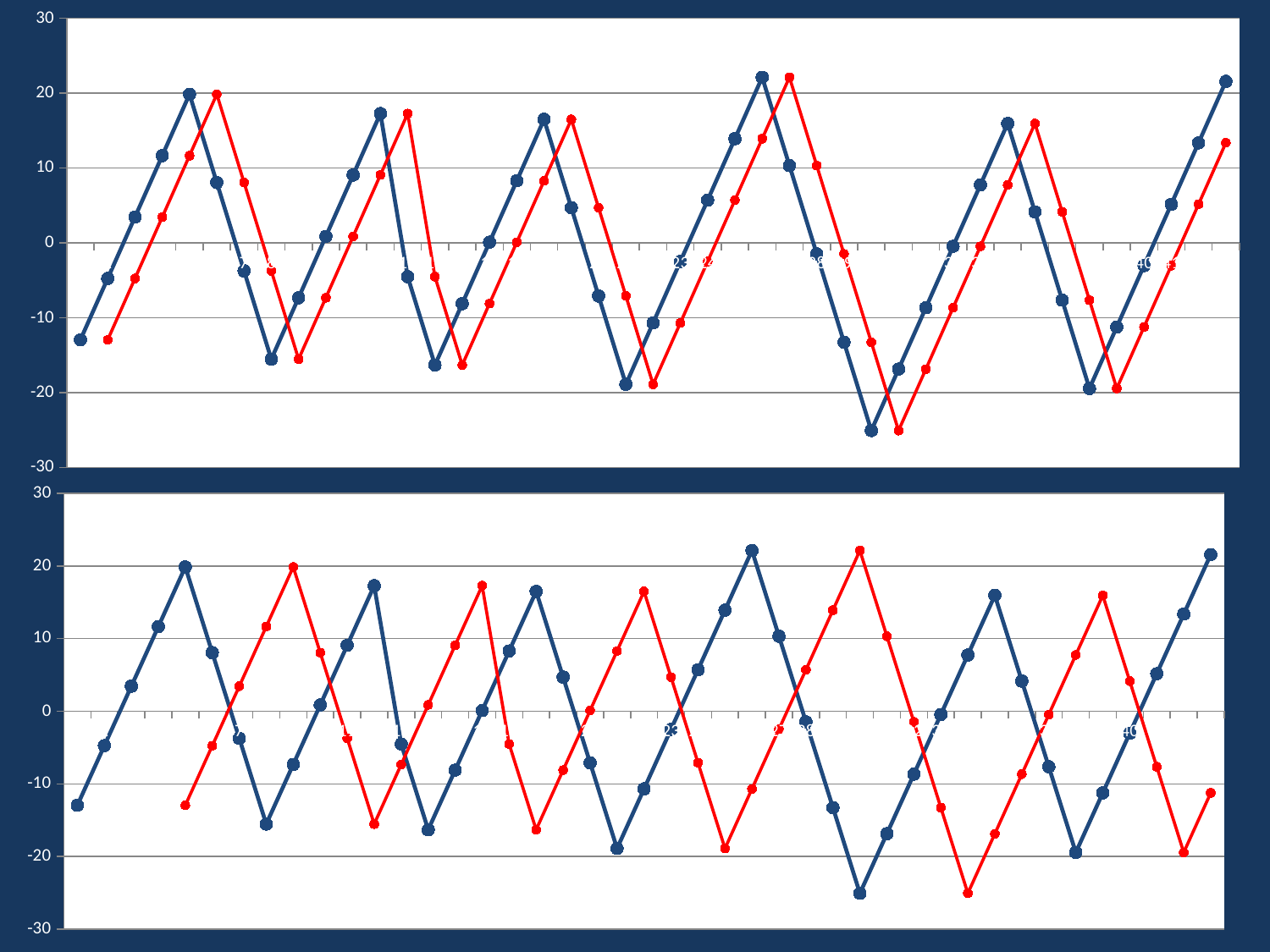
In the top chart, is the highest value reached by the blue line greater or less than 20? greater In the bottom chart, is the lowest value reached by the blue line greater or less than -20? less What kind of chart is the top chart on the slide? line chart What is the highest value shown on the vertical axis of the bottom chart? 30 In the bottom chart, is the lowest value reached by the red line greater or less than -20? less What kind of chart is the bottom chart on the slide? line chart How many charts are shown on the slide? 2 In the top chart, what colours are the two plotted lines? blue and red